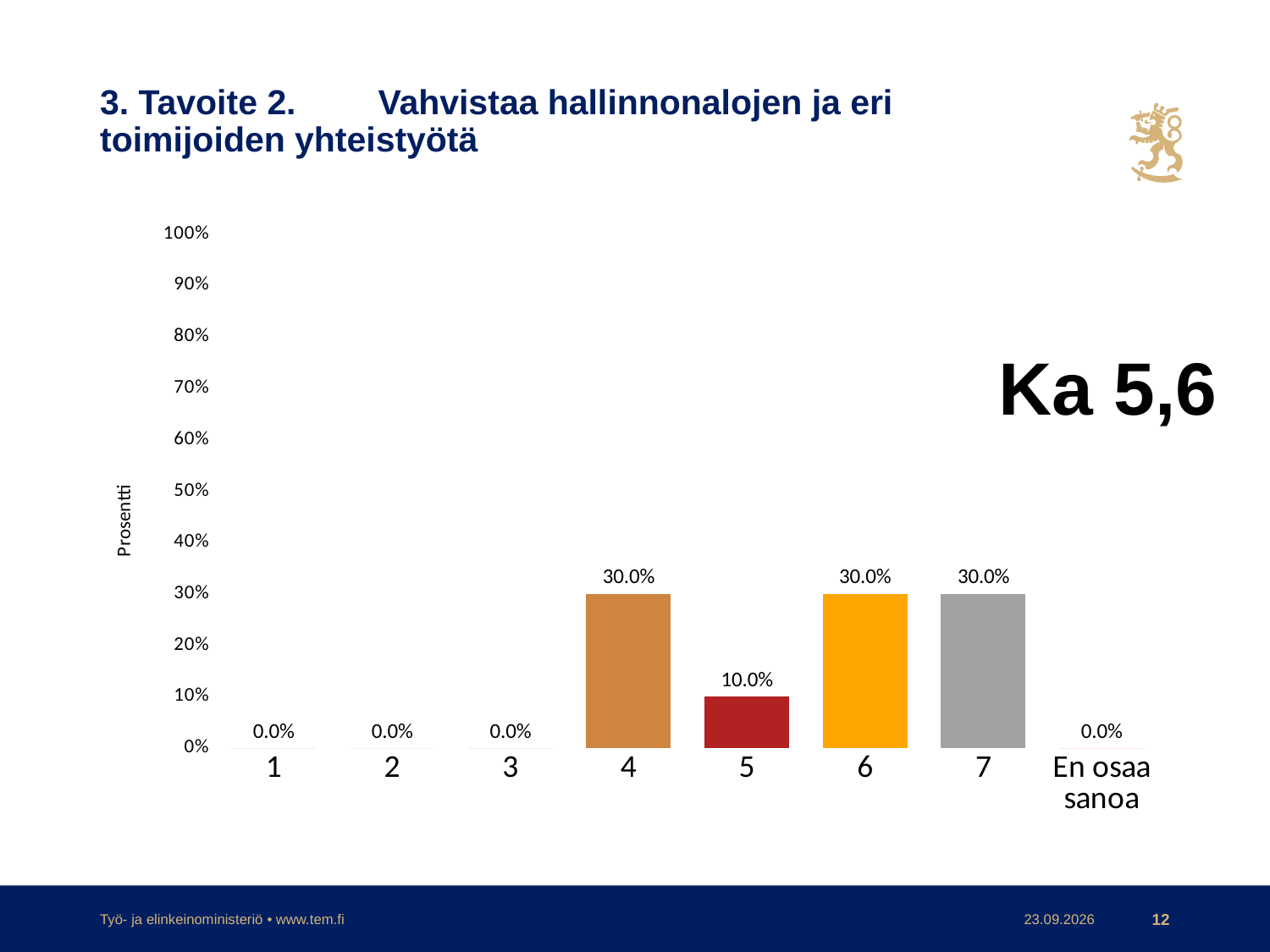
What kind of chart is shown on the slide? bar chart What is the value for category 4? 30.0% Is the value for category 7 greater or less than 20%? greater How many categories are shown on the x axis? 8 Which category has the lowest non-zero value? 5 What is the label of the y axis? Prosentti What is the value for category 1? 0.0% Which is larger, the value for category 6 or the value for category 5? 6 What is the difference between the values for category 4 and category 5? 20.0% How many categories have a value of 30.0%? 3 What is the value for 'En osaa sanoa'? 0.0% What is the value for category 5? 10.0%